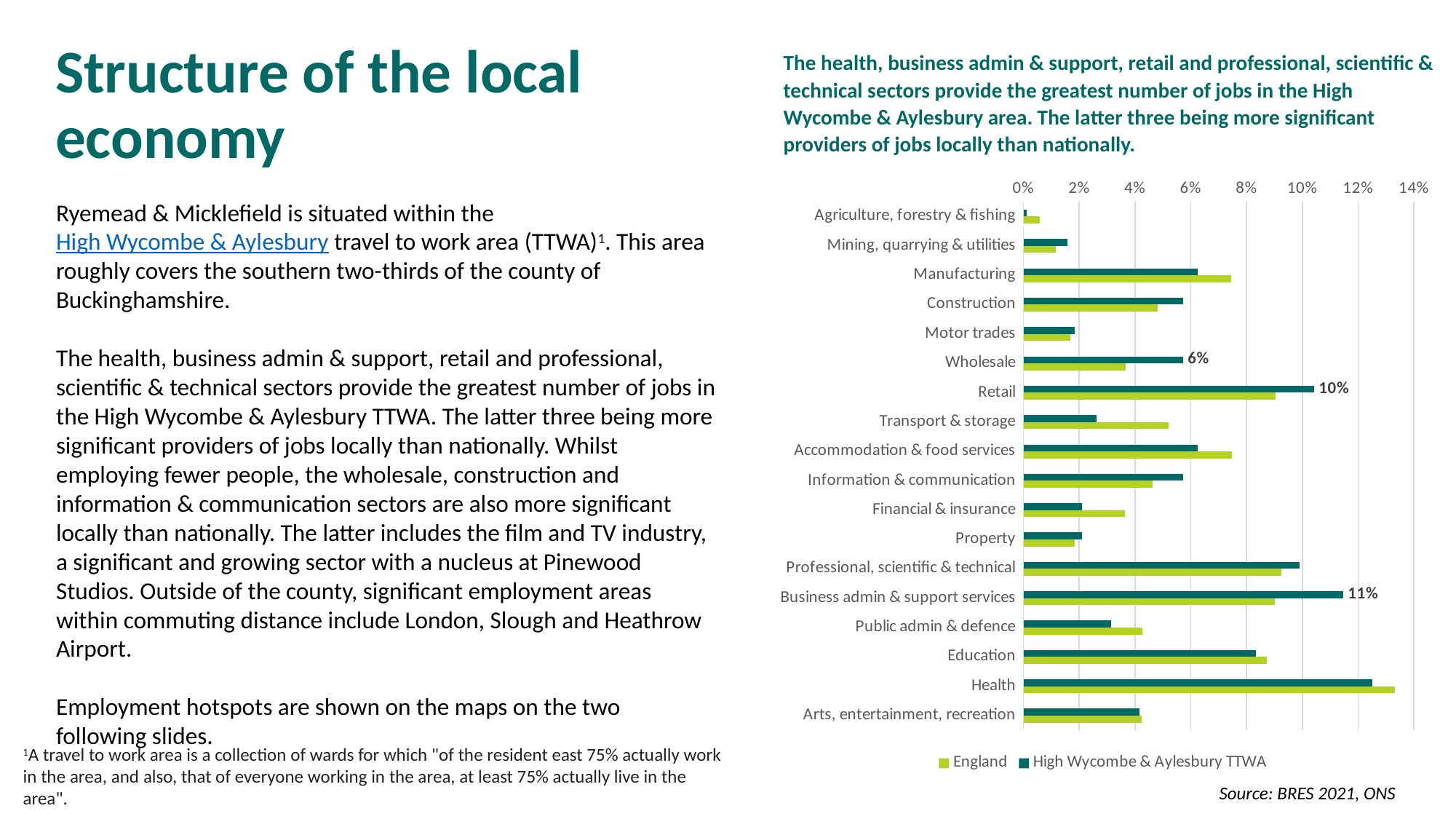
For Transport & storage, which series has the larger value, England or High Wycombe & Aylesbury TTWA? England How many sectors are shown on the chart? 18 For Retail, which series has the larger value, England or High Wycombe & Aylesbury TTWA? High Wycombe & Aylesbury TTWA Is the England value for Financial & insurance greater or less than 4%? less What is the value for Retail in the High Wycombe & Aylesbury TTWA series? 10% How many series does the chart's legend list? 2 Which sector has the highest value in the High Wycombe & Aylesbury TTWA series? Health What is the value for Business admin & support services in the High Wycombe & Aylesbury TTWA series? 11% Is the High Wycombe & Aylesbury TTWA value for Health greater or less than 12%? greater What is the difference between the High Wycombe & Aylesbury TTWA values for Business admin & support services and Retail? 1% Which sector has the lowest value in the England series? Agriculture, forestry & fishing What is the value for Wholesale in the High Wycombe & Aylesbury TTWA series? 6%